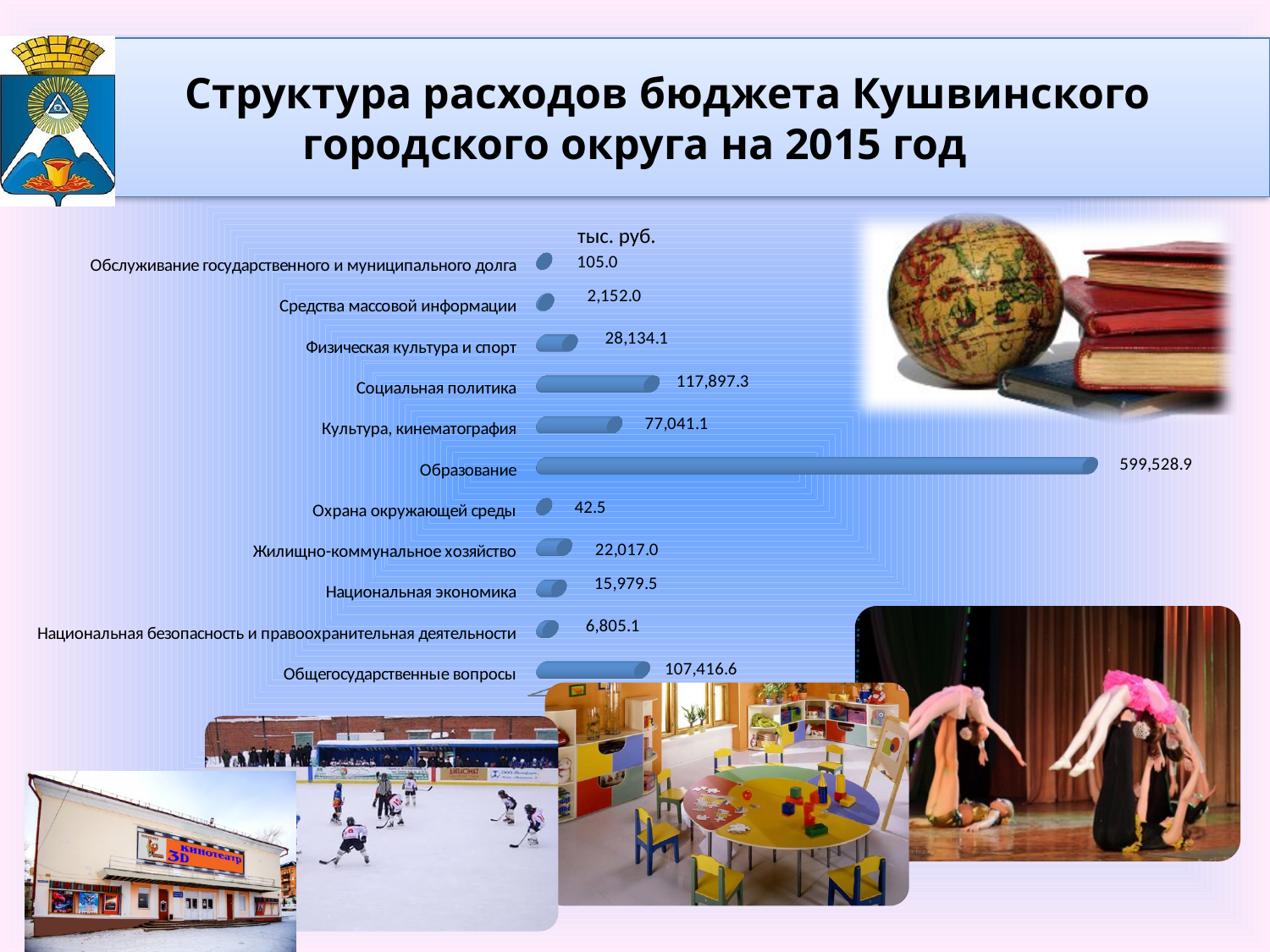
Which category has the highest value? Образование What is the value for Жилищно-коммунальное хозяйство? 22,017.0 What is the difference between the values for Социальная политика and Общегосударственные вопросы? 10,480.7 What is the value for Социальная политика? 117,897.3 What is the value for Охрана окружающей среды? 42.5 What unit is indicated above the chart? тыс. руб. What is the difference between the values for Физическая культура и спорт and Жилищно-коммунальное хозяйство? 6,117.1 How many categories are plotted in the chart? 11 What is the value for Образование? 599,528.9 Which category has the lowest value? Охрана окружающей среды What type of chart is shown on the slide? Bar chart Which is larger, the value for Культура, кинематография or the value for Общегосударственные вопросы? Общегосударственные вопросы